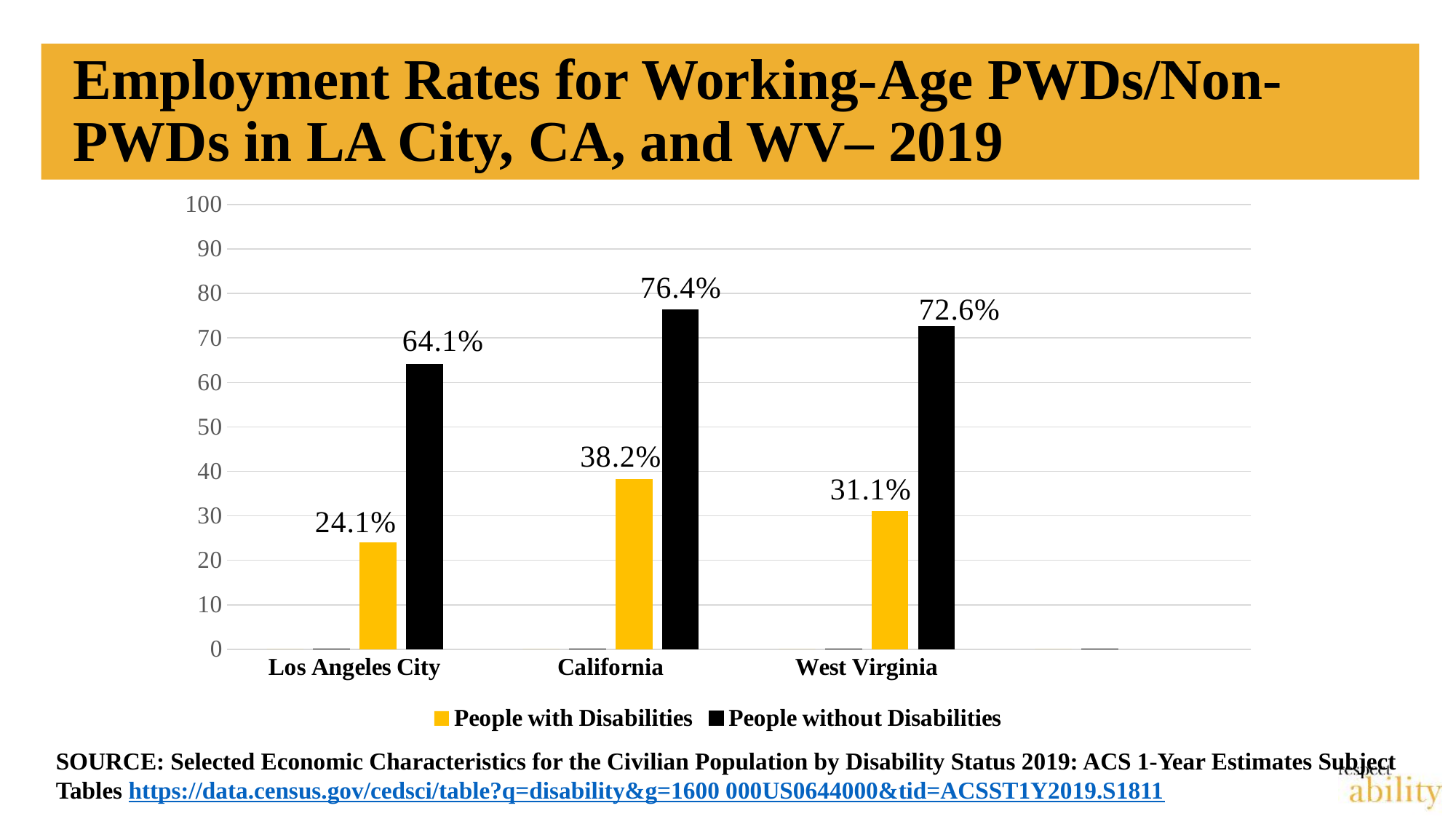
How many locations are shown on the x axis of the chart? 3 Which location has the highest employment rate for People with Disabilities? California How many series does the legend list? 2 What type of chart is shown on the slide? Bar chart What is the employment rate for People without Disabilities in California? 76.4% What is the difference between the employment rates for People without Disabilities and People with Disabilities in Los Angeles City? 40.0% Which location has the lowest employment rate for People without Disabilities? Los Angeles City What is the employment rate for People without Disabilities in West Virginia? 72.6% What is the difference between the employment rates for People with Disabilities in California and West Virginia? 7.1% What is the employment rate for People with Disabilities in Los Angeles City? 24.1% Which is larger: the employment rate for People without Disabilities in California or in West Virginia? California What is the employment rate for People with Disabilities in West Virginia? 31.1%